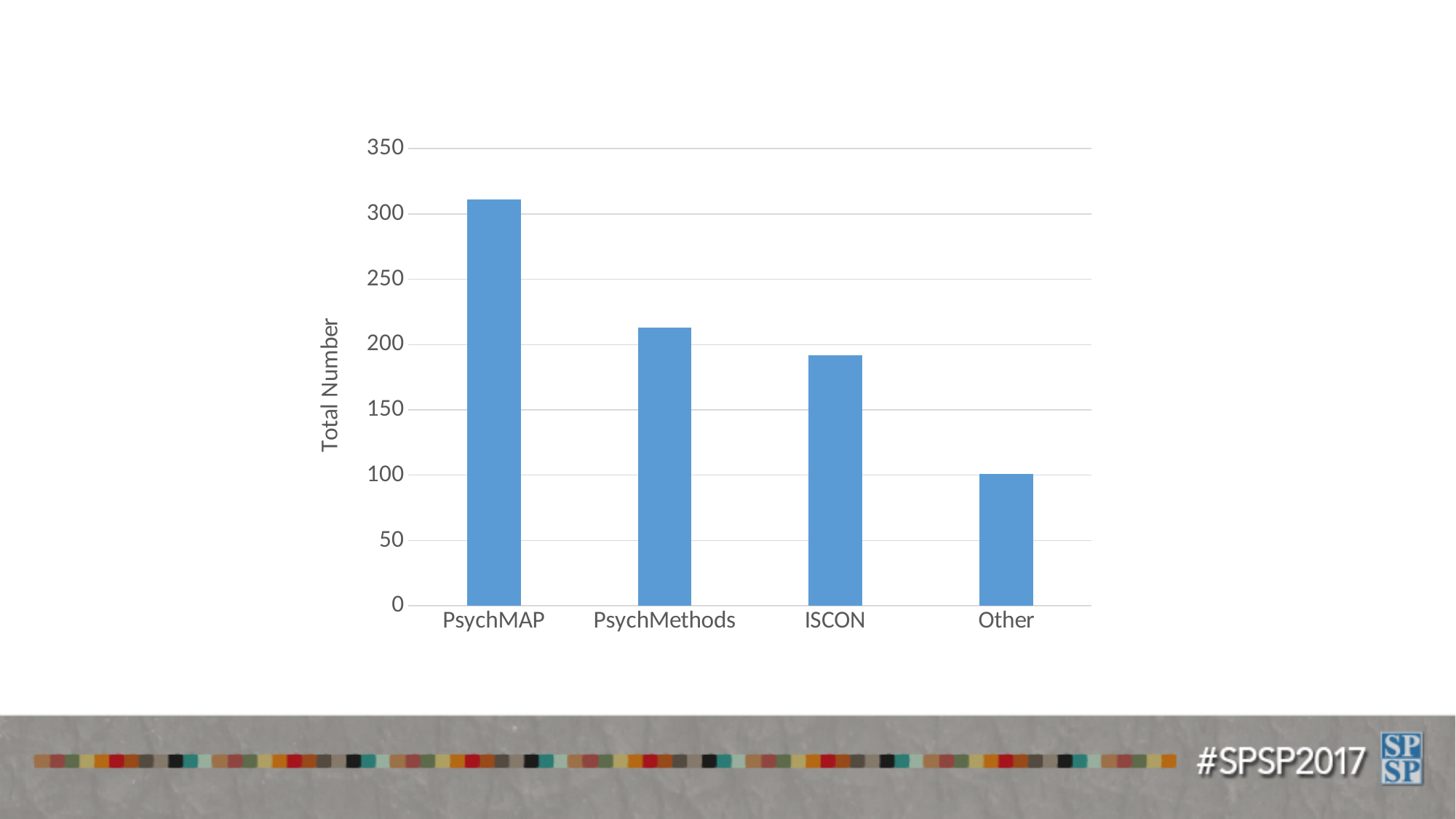
How many categories are shown on the x axis of the chart? 4 Which category has the lowest bar in the chart? Other Which is larger, the value for ISCON or the value for Other? ISCON Which is larger, the value for PsychMethods or the value for ISCON? PsychMethods Is the value for ISCON greater or less than 150? greater Is the value for PsychMethods greater or less than 200? greater Which category has the highest bar in the chart? PsychMAP Is the value for Other greater or less than 150? less Do the bar values rise or fall moving from left to right along the x axis? fall What is the label on the vertical axis of the chart? Total Number What kind of chart is shown on the slide? bar chart